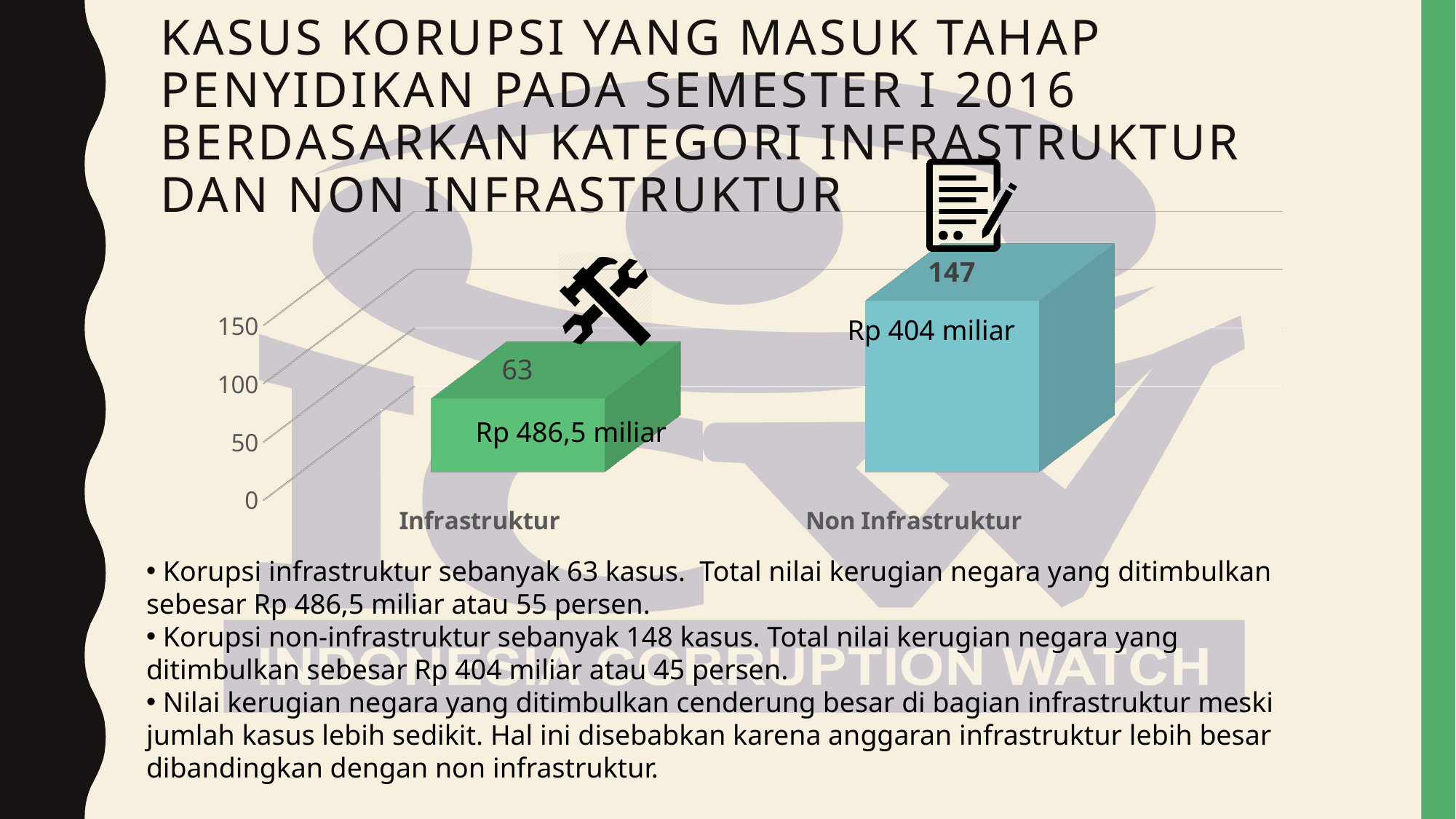
Is the value for Non Infrastruktur greater or less than 100? greater What monetary amount is labelled on the Infrastruktur bar? Rp 486,5 miliar What is the difference between the values for Non Infrastruktur and Infrastruktur? 84 How many categories are shown in the chart? 2 Is the value for Infrastruktur greater or less than 100? less What kind of chart is shown on the slide? bar chart What monetary amount is labelled on the Non Infrastruktur bar? Rp 404 miliar What is the value shown for Non Infrastruktur in the chart? 147 What is the value shown for Infrastruktur in the chart? 63 Is the value for Infrastruktur larger or smaller than the value for Non Infrastruktur? smaller Which category has the lower value in the chart? Infrastruktur Which category has the higher value in the chart? Non Infrastruktur